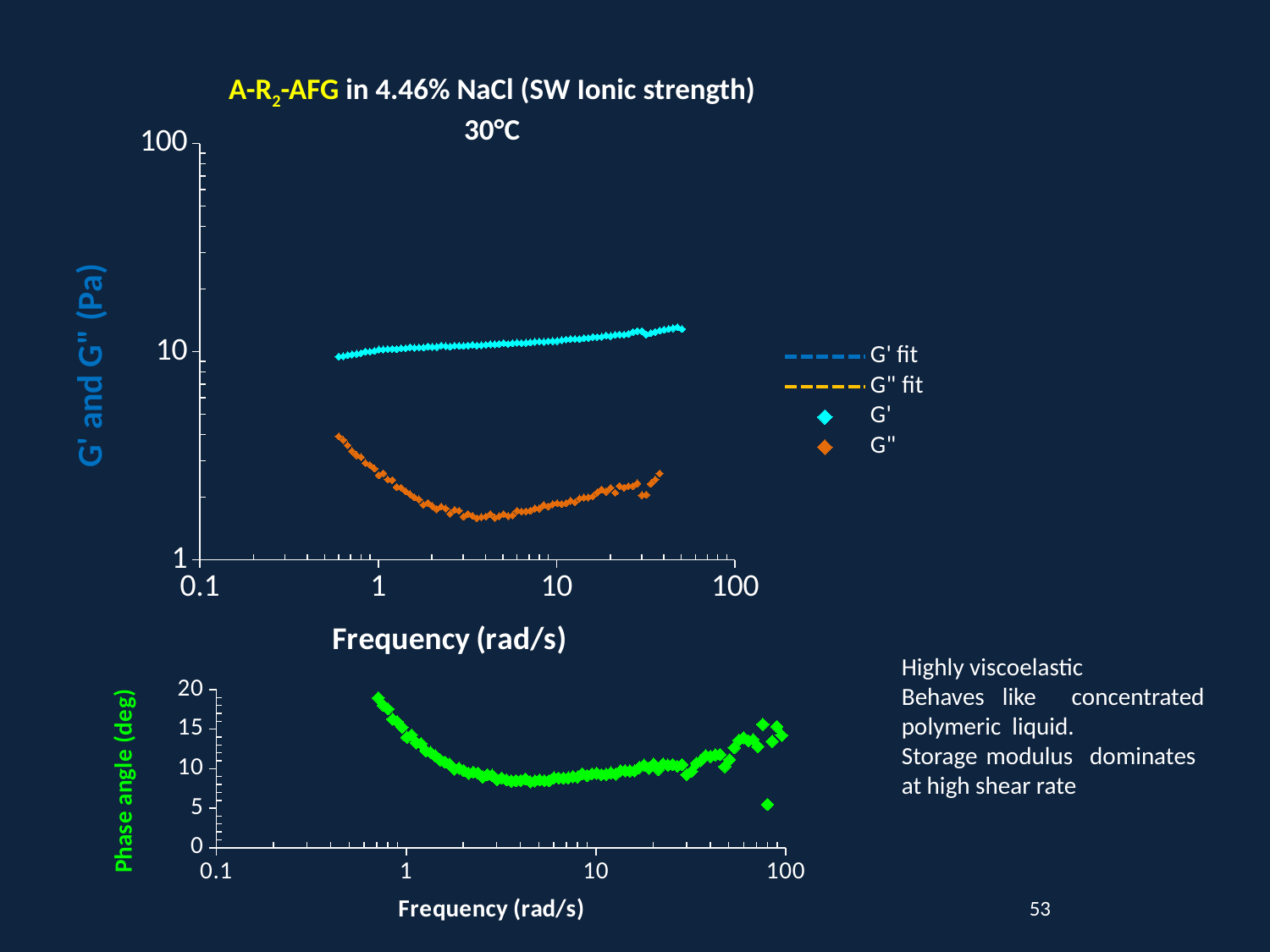
In the top chart, do the G' values rise or fall as frequency increases? rise What is the y-axis title of the top chart? G' and G'' (Pa) In the bottom chart, is the phase angle at a frequency of 1 rad/s greater or less than 10 degrees? greater How many series does the legend of the top chart list? 4 What kind of chart is the top chart titled "A-R2-AFG in 4.46% NaCl (SW Ionic strength) 30°C"? scatter chart In the top chart, which series has higher values across the frequency range, G' or G''? G' What is the highest value shown on the y-axis of the bottom chart (Phase angle)? 20 What is the x-axis title of the bottom chart? Frequency (rad/s) In the top chart, is the value of G'' at a frequency of 1 rad/s greater or less than 10 Pa? less In the bottom chart, does the phase angle rise or fall as frequency increases from 1 rad/s to 3 rad/s? fall